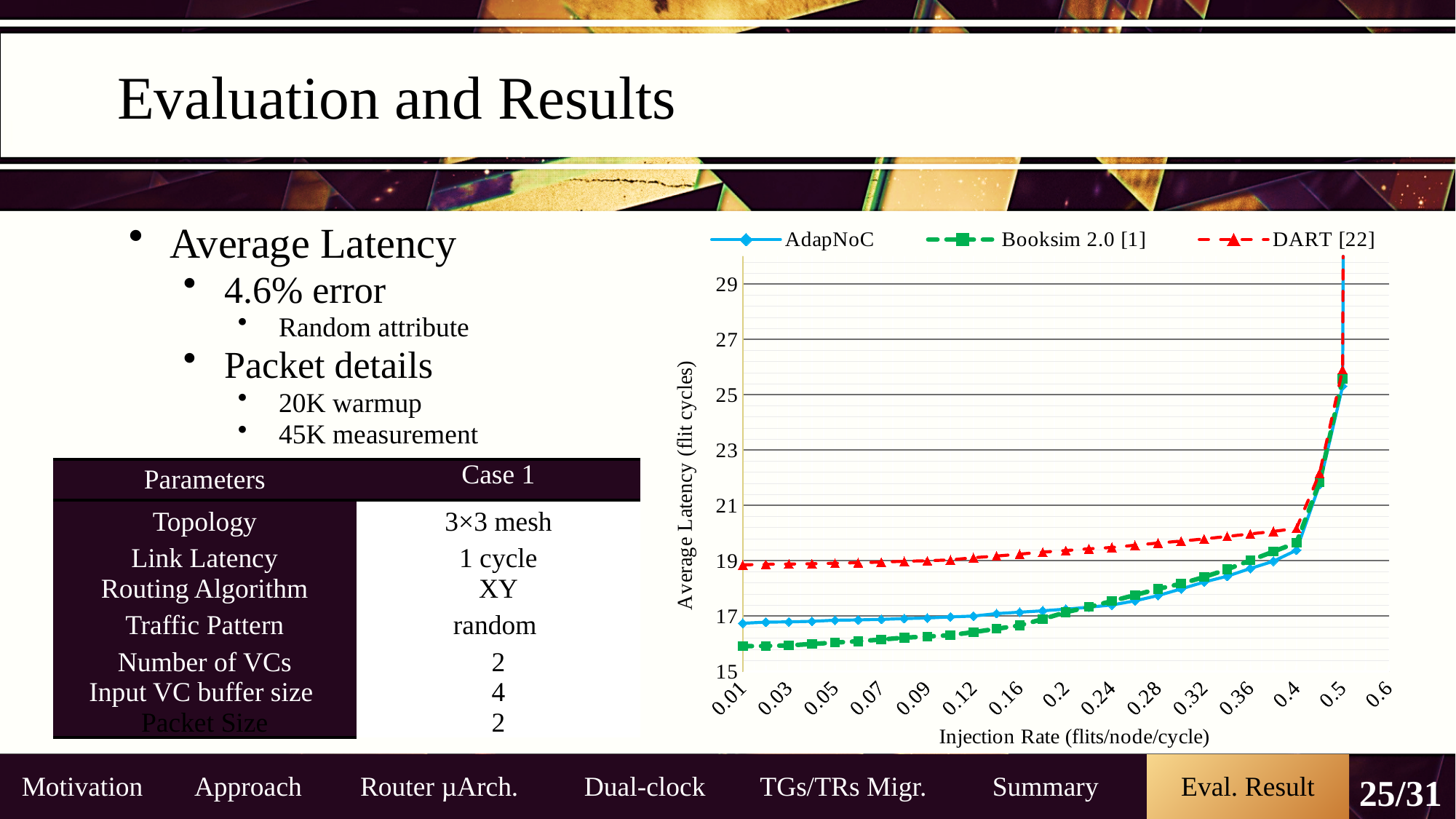
How many series does the chart legend list? 3 At injection rate 0.01, which series has the higher average latency, AdapNoC or Booksim 2.0 [1]? AdapNoC Which series has the highest average latency at injection rate 0.2? DART [22] How many injection rate tick labels are shown on the x axis? 15 What is the label of the chart's y axis? Average Latency (flit cycles) Is the AdapNoC average latency at injection rate 0.01 greater or less than 19? less Does the AdapNoC average latency rise or fall as the injection rate increases? rise Is the DART [22] average latency at injection rate 0.01 greater or less than 17? greater At injection rate 0.01, which series has the higher average latency, DART [22] or Booksim 2.0 [1]? DART [22] Is the Booksim 2.0 [1] average latency at injection rate 0.01 greater or less than 17? less Which series are listed in the chart legend? AdapNoC, Booksim 2.0 [1], DART [22] What kind of chart is shown on the slide? line chart